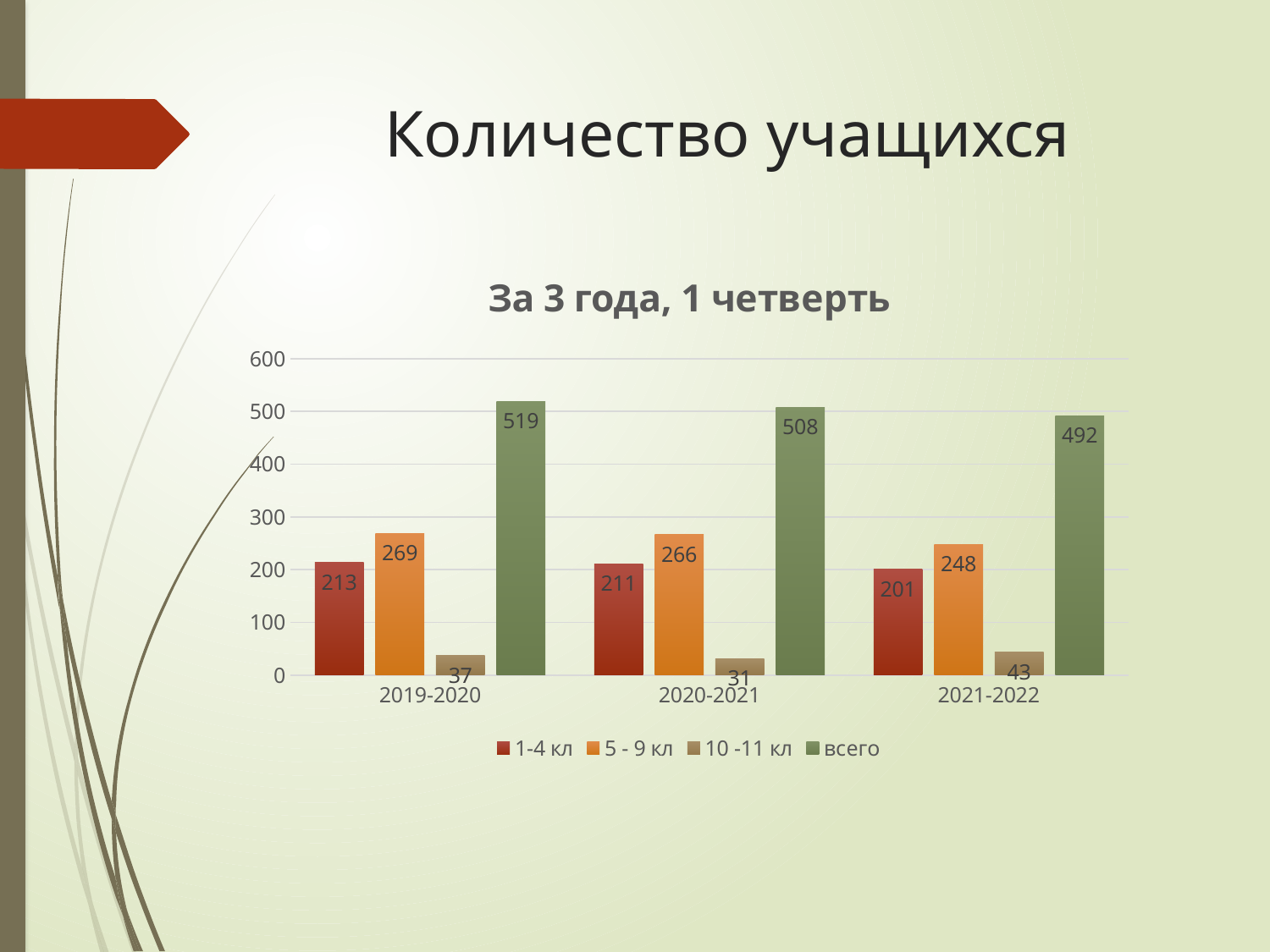
Which year has the lowest value for "1-4 кл"? 2021-2022 What is the value for "всего" in 2019-2020? 519 Which is larger: "5 - 9 кл" in 2019-2020 or "5 - 9 кл" in 2020-2021? 5 - 9 кл in 2019-2020 What is the value for "10 -11 кл" in 2020-2021? 31 Which year has the highest value for "всего"? 2019-2020 What is the value for "5 - 9 кл" in 2021-2022? 248 How many year categories are shown on the x axis? 3 What kind of chart is shown? bar chart How many series does the legend list? 4 Do the "всего" values rise or fall from 2019-2020 to 2021-2022? fall What is the difference between the "всего" values for 2019-2020 and 2021-2022? 27 Is the value for "всего" in 2021-2022 greater or less than 500? less